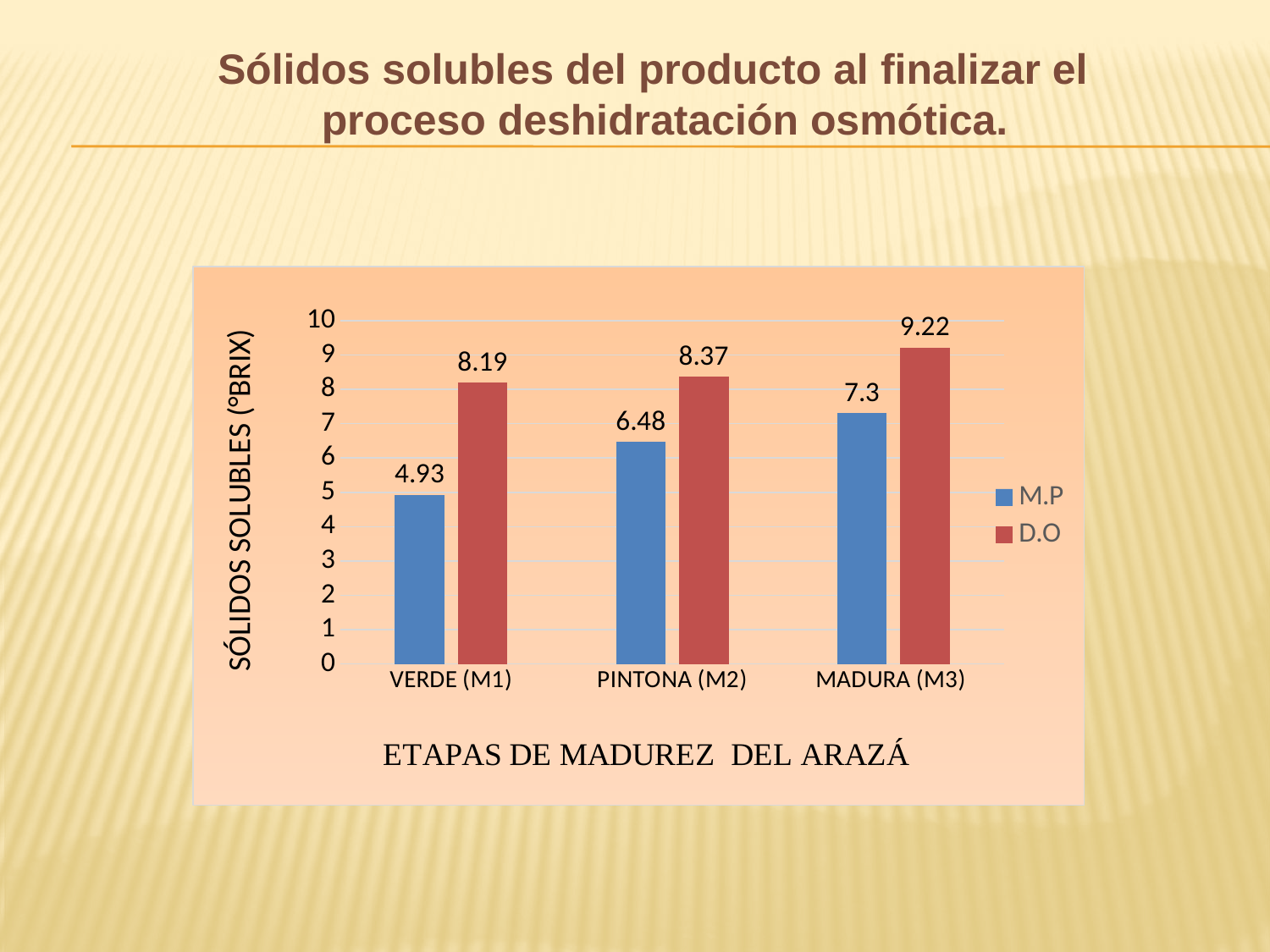
Which stage has the lowest M.P value? VERDE (M1) What kind of chart is shown on the slide? bar chart Which is larger, the M.P value for MADURA (M3) or the M.P value for PINTONA (M2)? MADURA (M3) What is the difference between the D.O and M.P values for VERDE (M1)? 3.26 What is the D.O value for PINTONA (M2)? 8.37 Is the M.P value for PINTONA (M2) greater or less than 7? less What is the M.P value for VERDE (M1)? 4.93 What is the D.O value for MADURA (M3)? 9.22 How many maturity stages are shown on the x axis? 3 Do the M.P values rise or fall from VERDE (M1) to MADURA (M3)? rise How many series does the legend list? 2 Which stage has the highest D.O value? MADURA (M3)